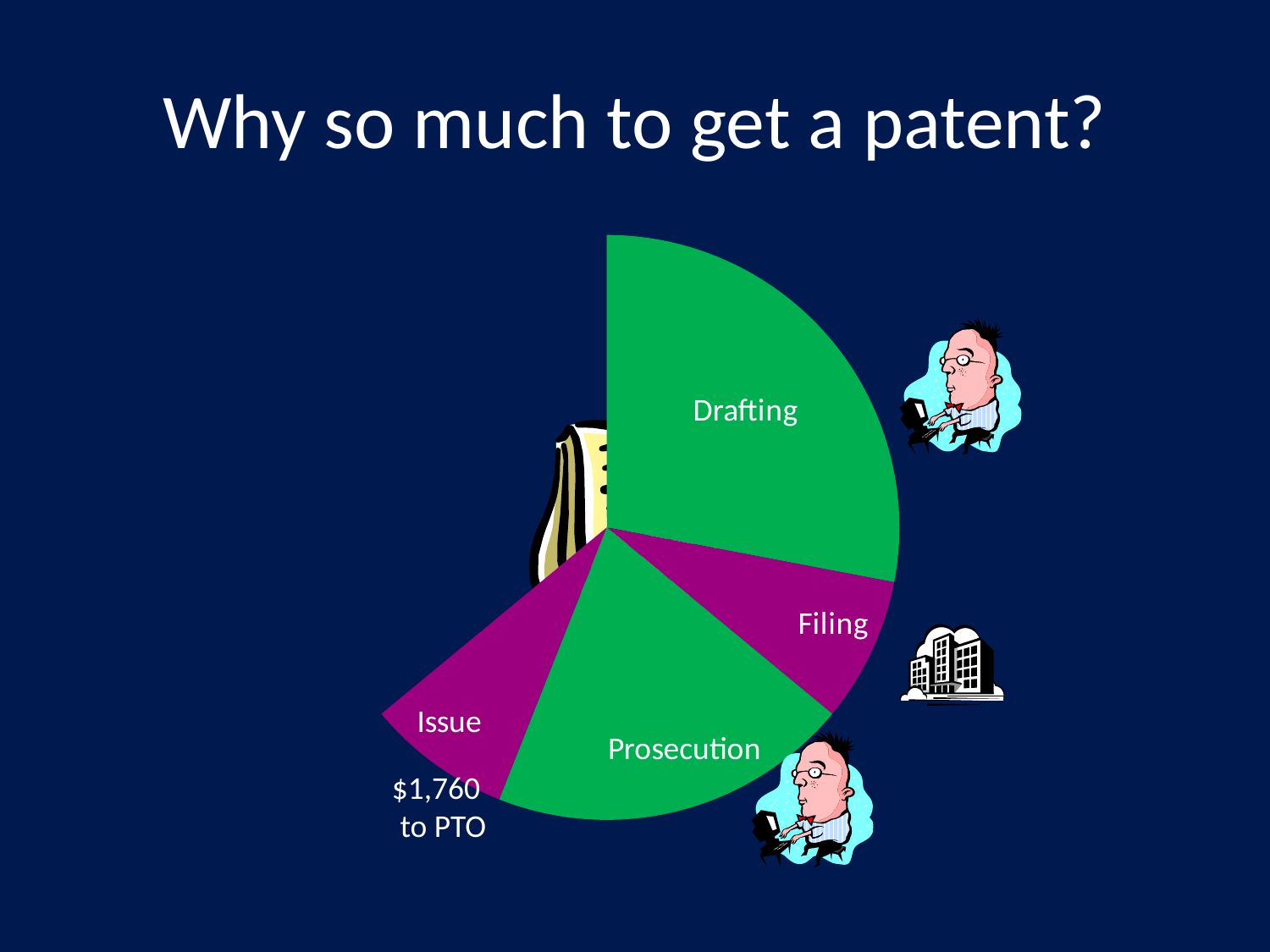
Which is larger in the pie chart, Drafting or Prosecution? Drafting Which slice of the pie chart has the annotation "$1,760 to PTO" next to it? Issue What colour is the Filing slice of the pie chart? purple What kind of chart is shown on the slide? pie chart Which slice of the pie chart is the largest? Drafting What is the title of the slide containing the pie chart? Why so much to get a patent? How many slices does the pie chart have? 4 Which is larger in the pie chart, Prosecution or Filing? Prosecution Which is larger in the pie chart, Prosecution or Issue? Prosecution